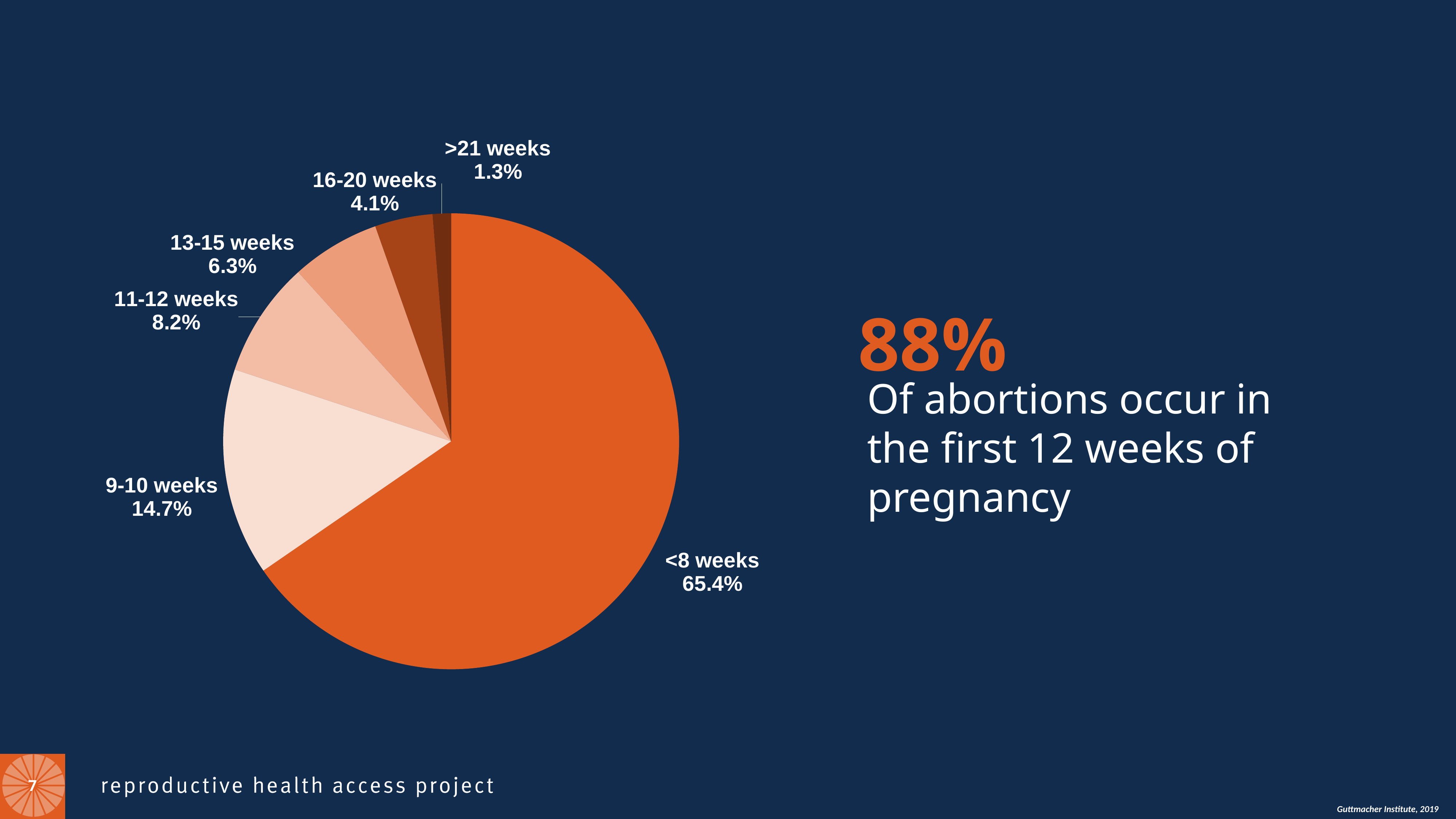
What is the value for the 16-20 weeks slice? 4.1% What is the difference between the 9-10 weeks and 11-12 weeks slices? 6.5% Which slice of the pie is the largest? <8 weeks What is the value for the 9-10 weeks slice? 14.7% What kind of chart is shown on the slide? pie chart Which slice of the pie is the smallest? >21 weeks What share of abortions occur at <8 weeks? 65.4% How many slices does the pie chart have? 6 Which is larger, the 13-15 weeks slice or the 16-20 weeks slice? 13-15 weeks What is the value for the 11-12 weeks slice? 8.2% What percentage does the large text next to the chart state occur in the first 12 weeks of pregnancy? 88% What is the value for the 13-15 weeks slice? 6.3%